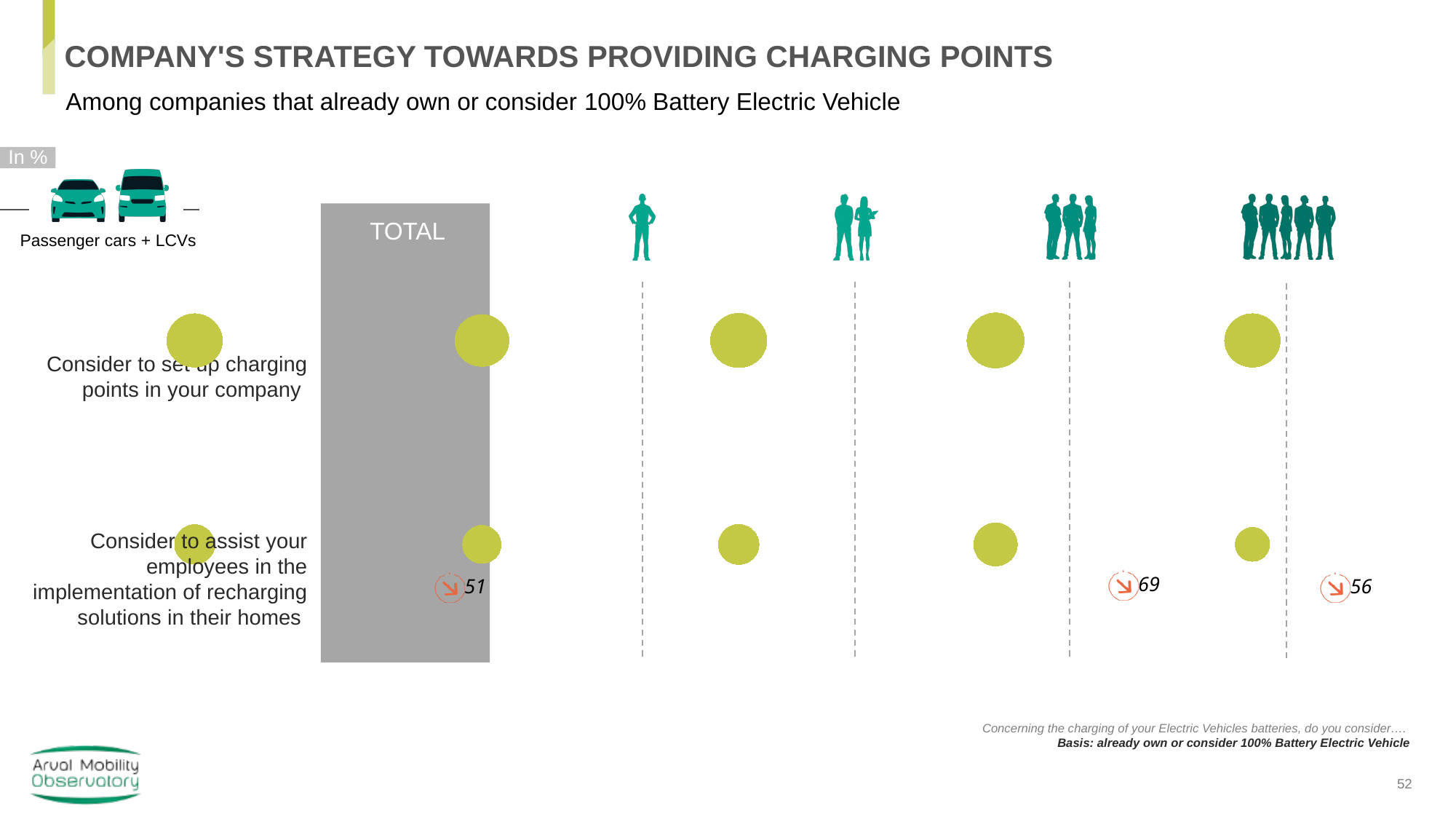
What kind of chart is used on this slide to show the results? bubble chart How many statements (rows) are plotted in the chart? 2 What is the title of the chart on this slide? COMPANY'S STRATEGY TOWARDS PROVIDING CHARGING POINTS In the rightmost column, is the bubble for 'Consider to set up charging points in your company' larger or smaller than the bubble for 'Consider to assist your employees in the implementation of recharging solutions in their homes'? larger How many columns of bubbles are shown, including the TOTAL column? 5 In the TOTAL column, which statement has the larger bubble? Consider to set up charging points in your company What number is printed next to the downward arrow in the TOTAL column? 51